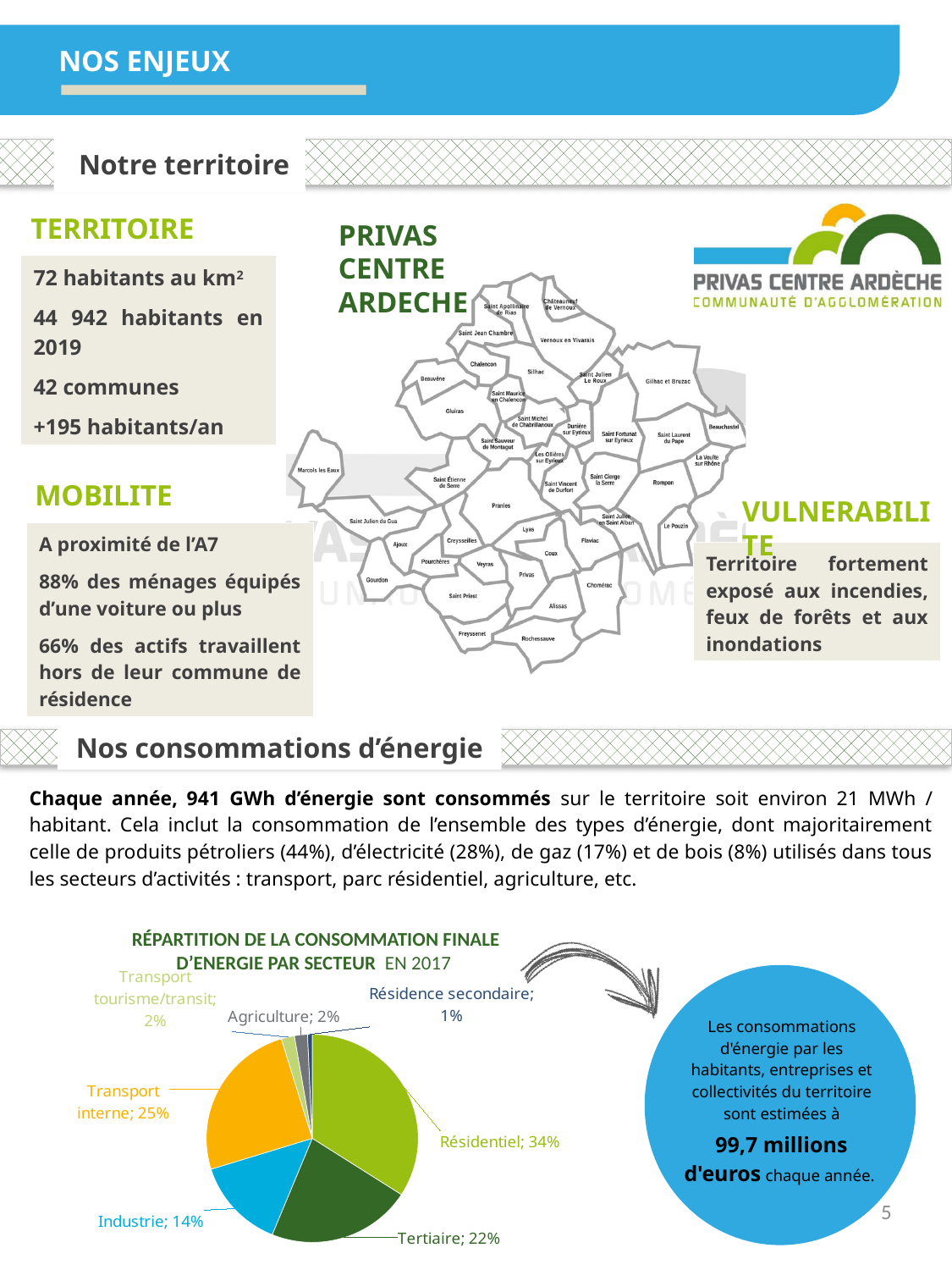
What is the value shown for Tertiaire? 22% What is the value shown for Résidence secondaire? 1% What type of chart is shown on the slide? pie chart Which sector has the smallest share of the pie? Résidence secondaire What share of final energy consumption does the Résidentiel sector represent? 34% Which sector has the largest share of the pie? Résidentiel What is the value shown for Industrie? 14% What is the value shown for Transport interne? 25% How many slices does the pie chart have? 7 What is the difference between the shares of Transport interne and Industrie? 11% What is the title of the chart? RÉPARTITION DE LA CONSOMMATION FINALE D'ENERGIE PAR SECTEUR EN 2017 Which is larger, the share for Tertiaire or the share for Transport interne? Transport interne